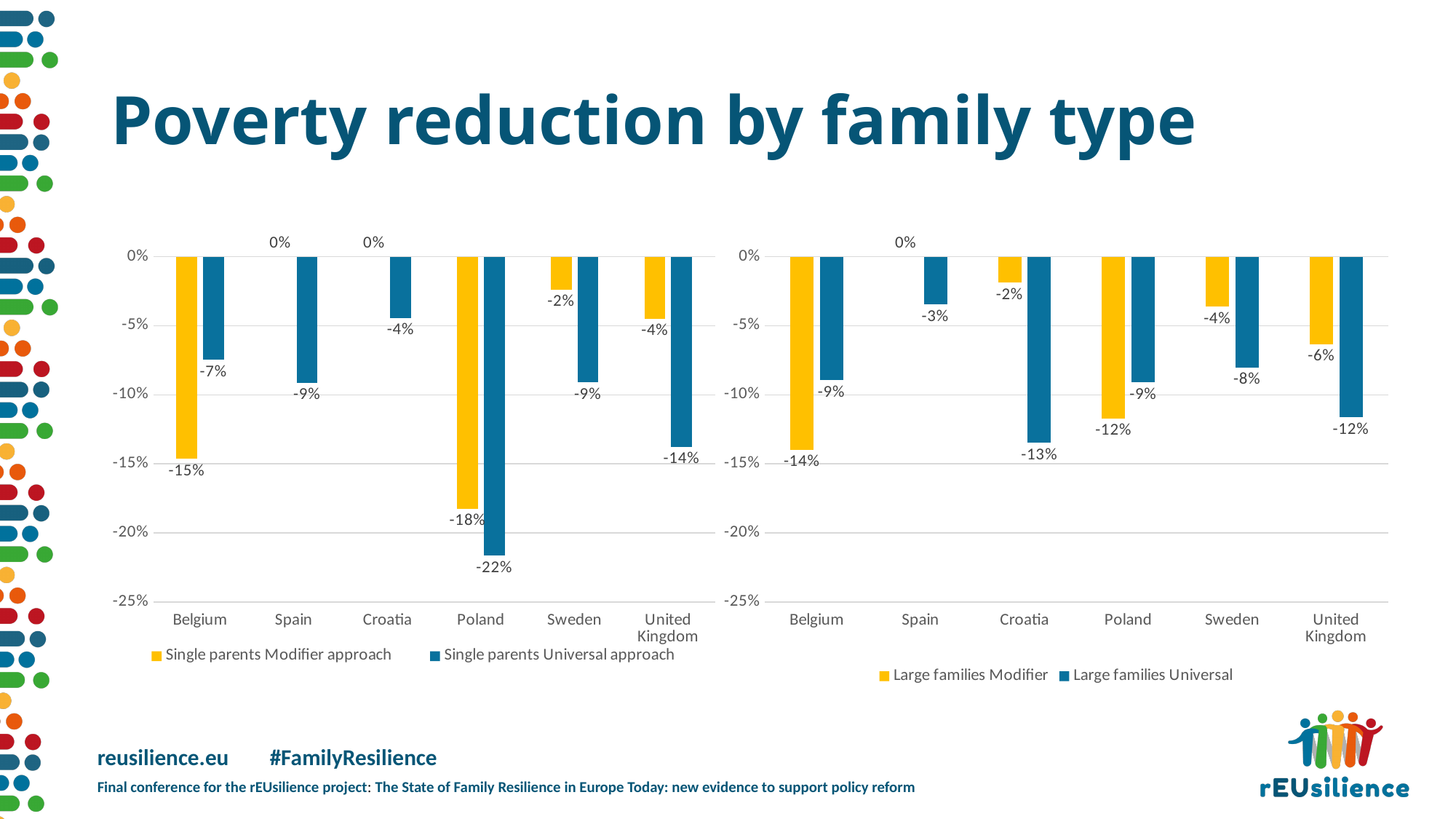
In the right chart, what is the value for the United Kingdom for Large families Modifier? -6% In the left chart, what is the value for Poland under the Single parents Universal approach? -22% In the left chart, what is the difference between the Single parents Universal approach and the Single parents Modifier approach values for the United Kingdom? 10 percentage points How many countries are shown on the x axis of the left chart? 6 In the left chart, which country has the largest poverty reduction under the Single parents Universal approach? Poland In the left chart, what is the value for Belgium under the Single parents Modifier approach? -15% In the right chart, which is larger in magnitude for Poland: Large families Modifier or Large families Universal? Large families Modifier In the right chart, what is the value for Croatia for Large families Universal? -13% What type of chart is the left chart? Bar chart How many series does the legend of the right chart list? 2 In the left chart, which colour represents the Single parents Modifier approach? Yellow In the right chart, which country has the smallest poverty reduction for Large families Universal? Spain